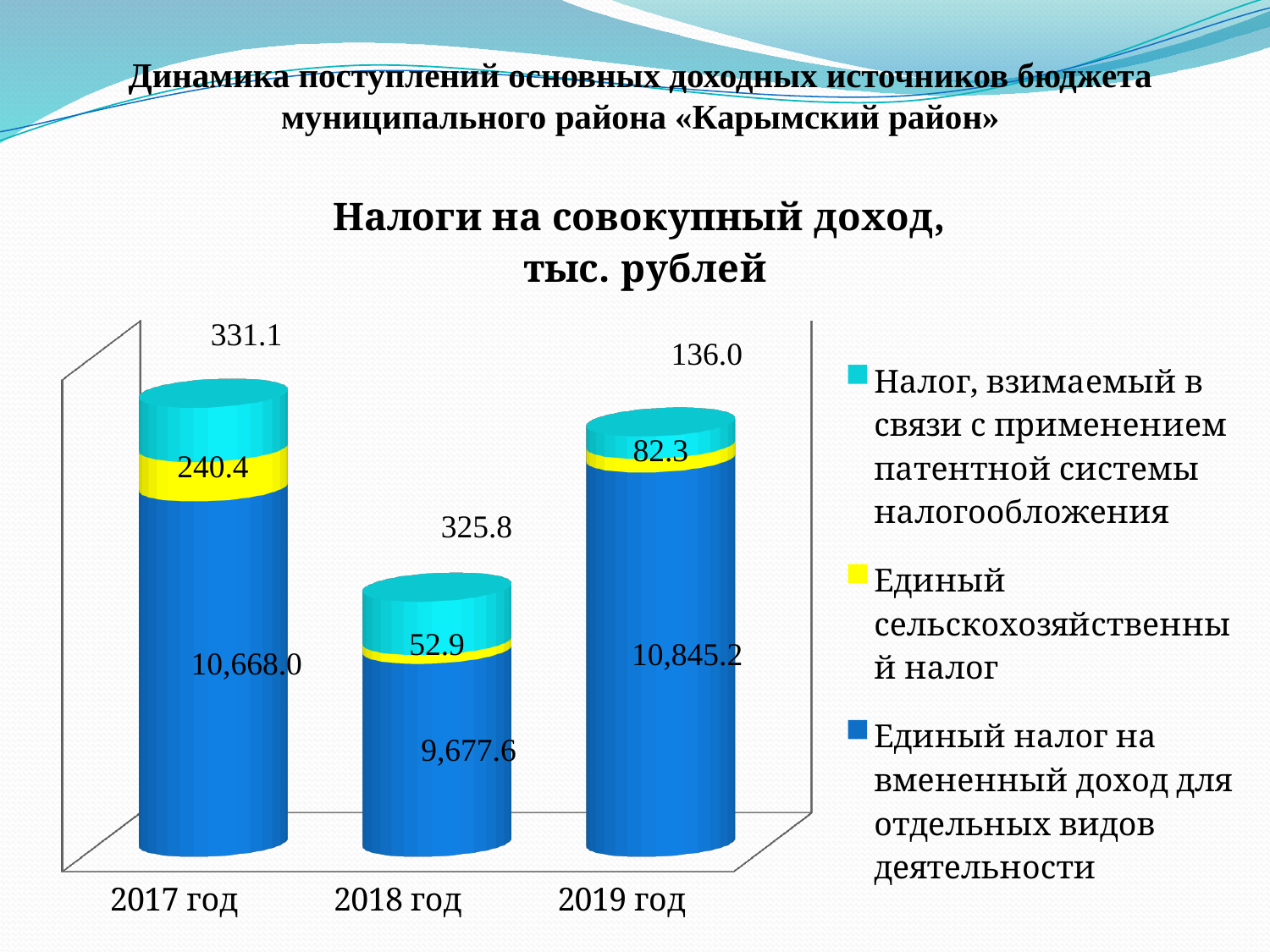
What is the value of the patent system tax (Налог, взимаемый в связи с применением патентной системы налогообложения) for 2019 год? 136.0 What kind of chart is shown on the slide? Stacked bar chart What is the difference between the unified tax on imputed income in 2019 год and in 2017 год? 177.2 How many years (categories) are shown on the x axis? 3 What is the title of the chart? Налоги на совокупный доход, тыс. рублей What is the value of the unified tax on imputed income (Единый налог на вмененный доход) for 2017 год? 10,668.0 Which is larger: the patent system tax in 2017 год or in 2018 год? 2017 год What is the total of the stacked bar for 2018 год? 10,056.3 In which year is the unified tax on imputed income (blue segment) the highest? 2019 год How many series does the legend list? 3 In which year is the unified agricultural tax (yellow segment) the lowest? 2018 год What is the value of the unified agricultural tax (Единый сельскохозяйственный налог) for 2018 год? 52.9